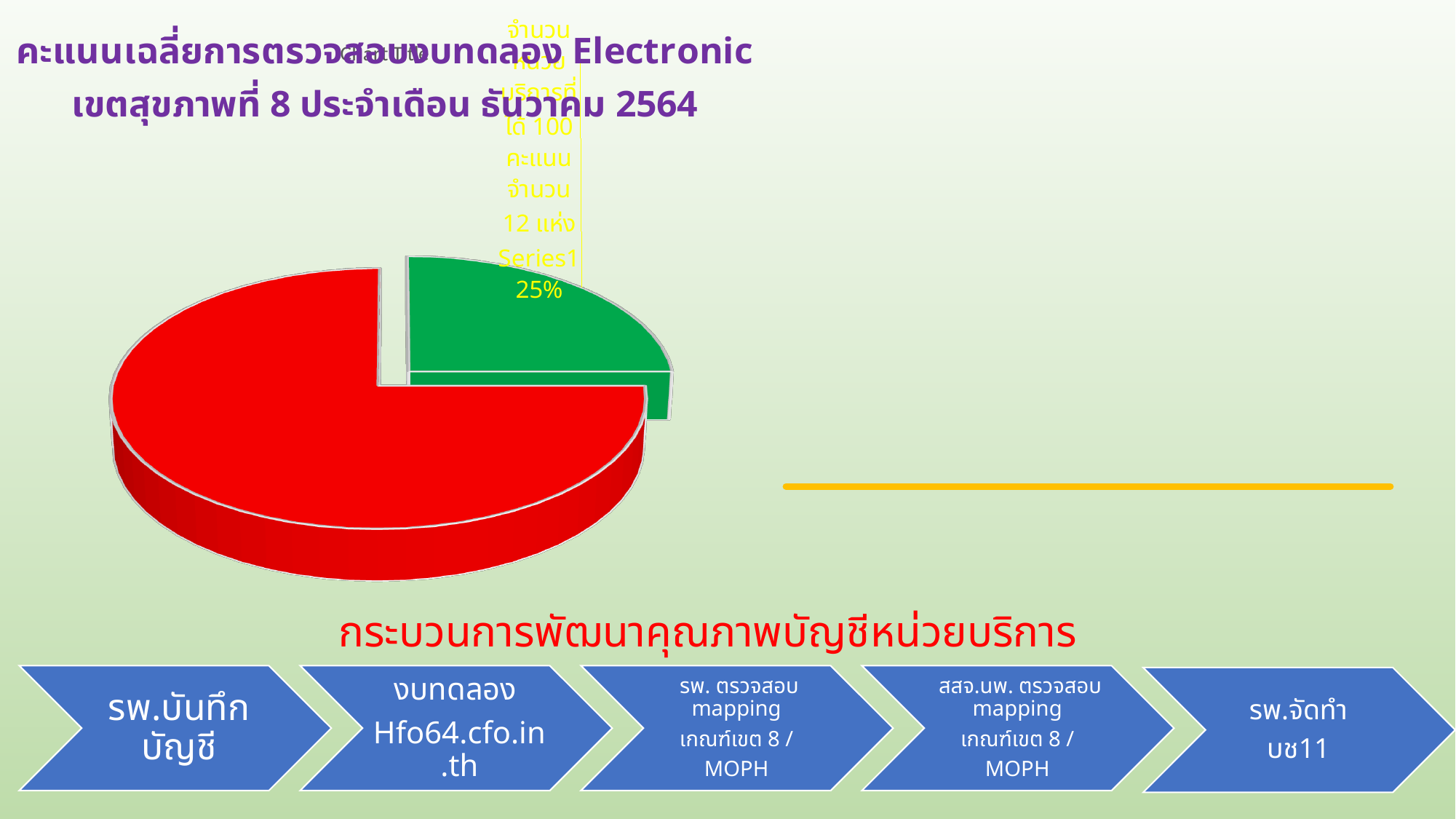
Which slice of the pie chart is the smallest, the red one or the green one? the green one What kind of chart is shown on the slide? pie chart Is the red slice of the pie chart larger or smaller than the green slice? larger How many slices does the pie chart have? 2 What series name is printed in the data label of the green slice? Series1 What colour is the slice labelled 25% in the pie chart? green What percentage is printed on the green slice of the pie chart? 25% Which slice of the pie chart is the largest, the red one or the green one? the red one How many units (แห่ง) does the data label on the green slice say scored 100 points? 12 แห่ง